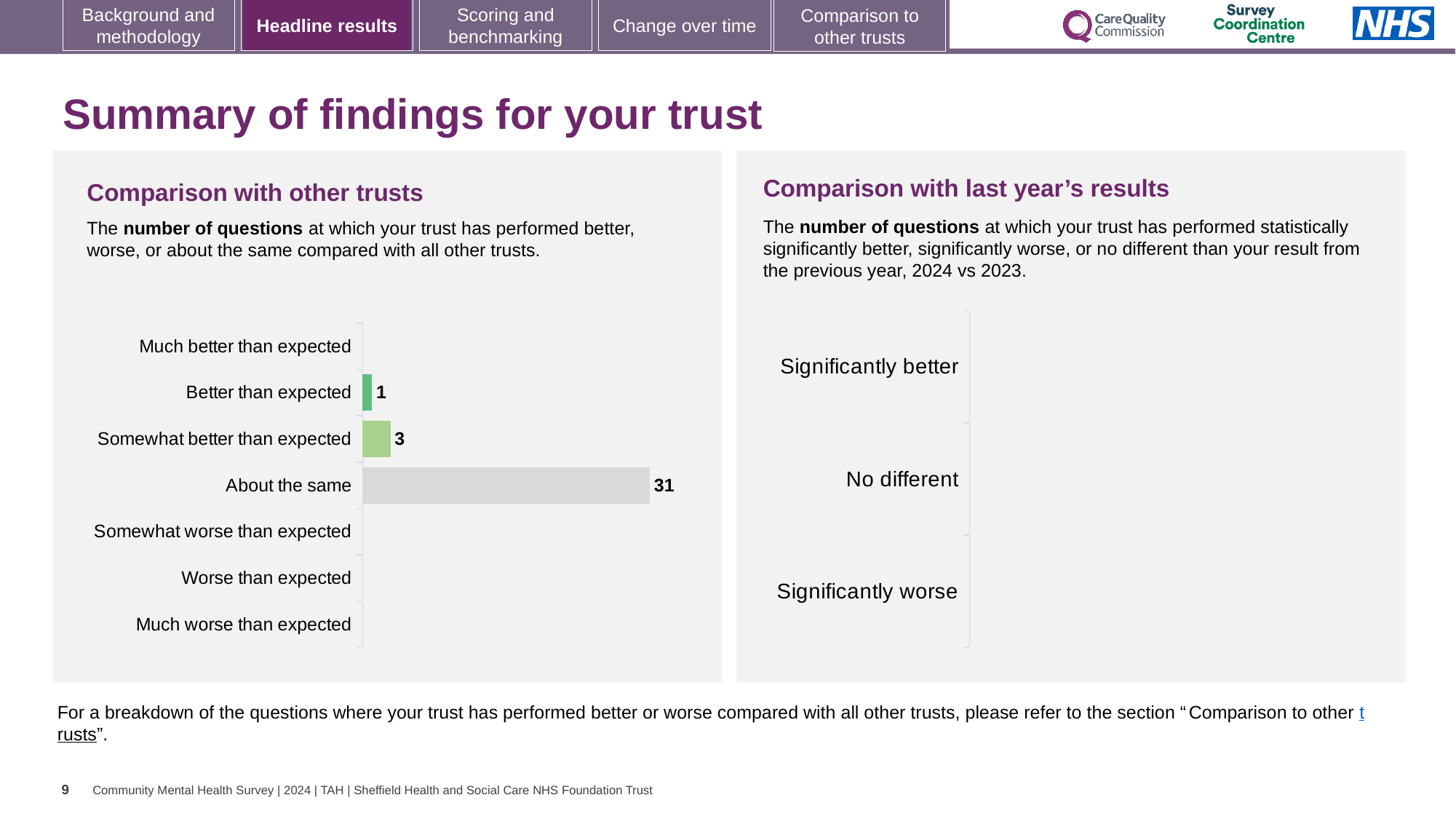
In the 'Comparison with other trusts' chart, what is the value for 'Better than expected'? 1 In the 'Comparison with other trusts' chart, how many categories are listed on the axis? 7 What is the title of the chart on the right side of the slide? Comparison with last year's results In the 'Comparison with other trusts' chart, what colour is the 'About the same' bar? Grey In the 'Comparison with other trusts' chart, what is the value for 'Somewhat better than expected'? 3 In the 'Comparison with other trusts' chart, what is the difference between 'Somewhat better than expected' and 'Better than expected'? 2 In the 'Comparison with other trusts' chart, which category has the highest value? About the same In the 'Comparison with other trusts' chart, how many questions are 'About the same'? 31 In the 'Comparison with last year's results' chart, how many categories are listed on the axis? 3 In the 'Comparison with other trusts' chart, what is the difference between 'About the same' and 'Somewhat better than expected'? 28 What kind of chart is the 'Comparison with other trusts' chart? Bar chart In the 'Comparison with other trusts' chart, which is larger: 'Better than expected' or 'Somewhat better than expected'? Somewhat better than expected